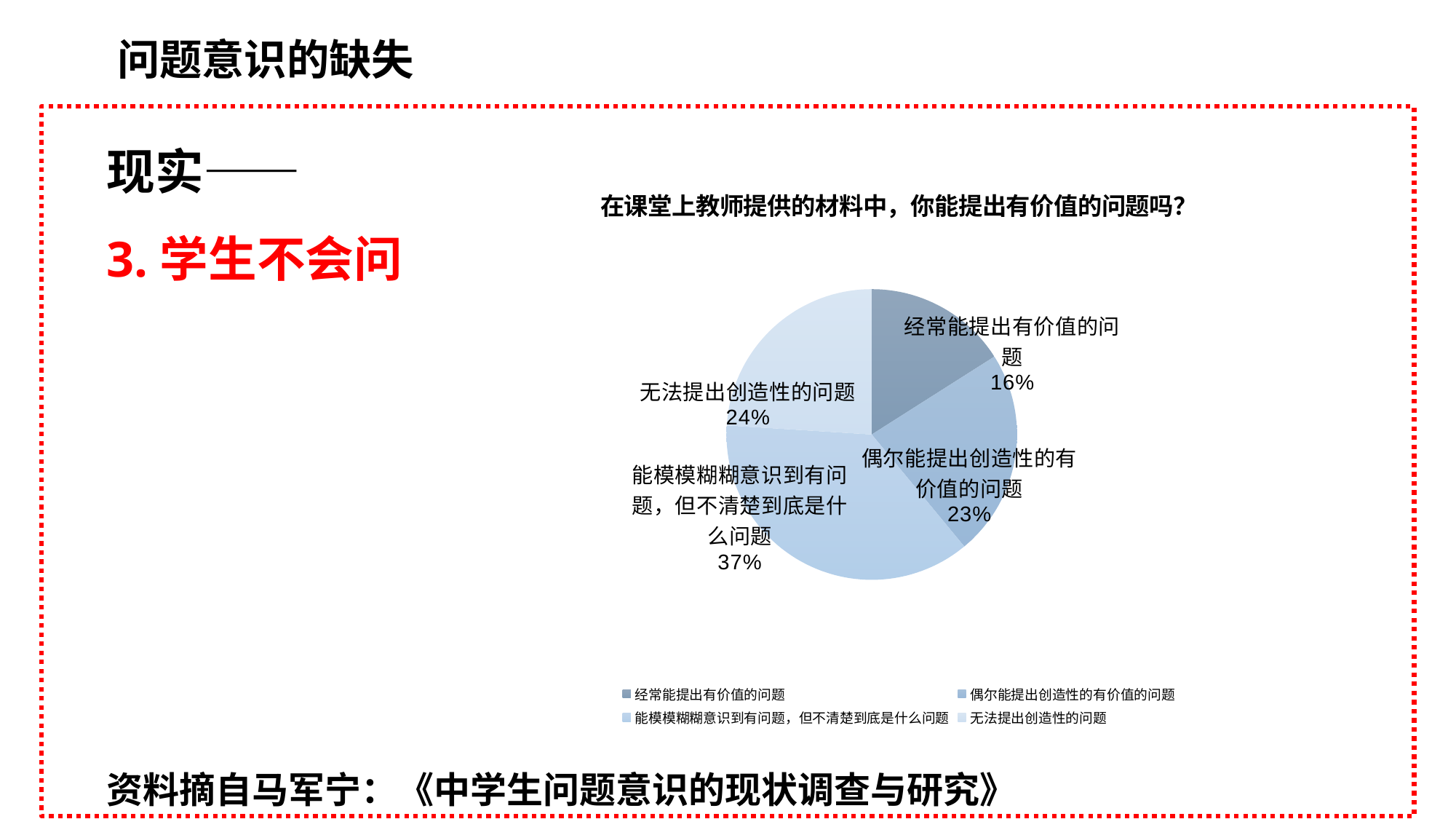
What kind of chart is shown on the slide? pie chart Which slice of the pie chart is the smallest? 经常能提出有价值的问题 What percentage of the pie is labelled 能模模糊糊意识到有问题，但不清楚到底是什么问题? 37% Which slice of the pie chart is the largest? 能模模糊糊意识到有问题，但不清楚到底是什么问题 What percentage of the pie is labelled 偶尔能提出创造性的有价值的问题? 23% How many slices does the pie chart have? 4 What is the title of the pie chart? 在课堂上教师提供的材料中，你能提出有价值的问题吗? What percentage of the pie is labelled 经常能提出有价值的问题? 16% What percentage of the pie is labelled 无法提出创造性的问题? 24% How many entries does the legend of the pie chart list? 4 Which is larger, the 无法提出创造性的问题 slice or the 偶尔能提出创造性的有价值的问题 slice? 无法提出创造性的问题 What is the difference in percentage points between the 能模模糊糊意识到有问题，但不清楚到底是什么问题 slice and the 经常能提出有价值的问题 slice? 21